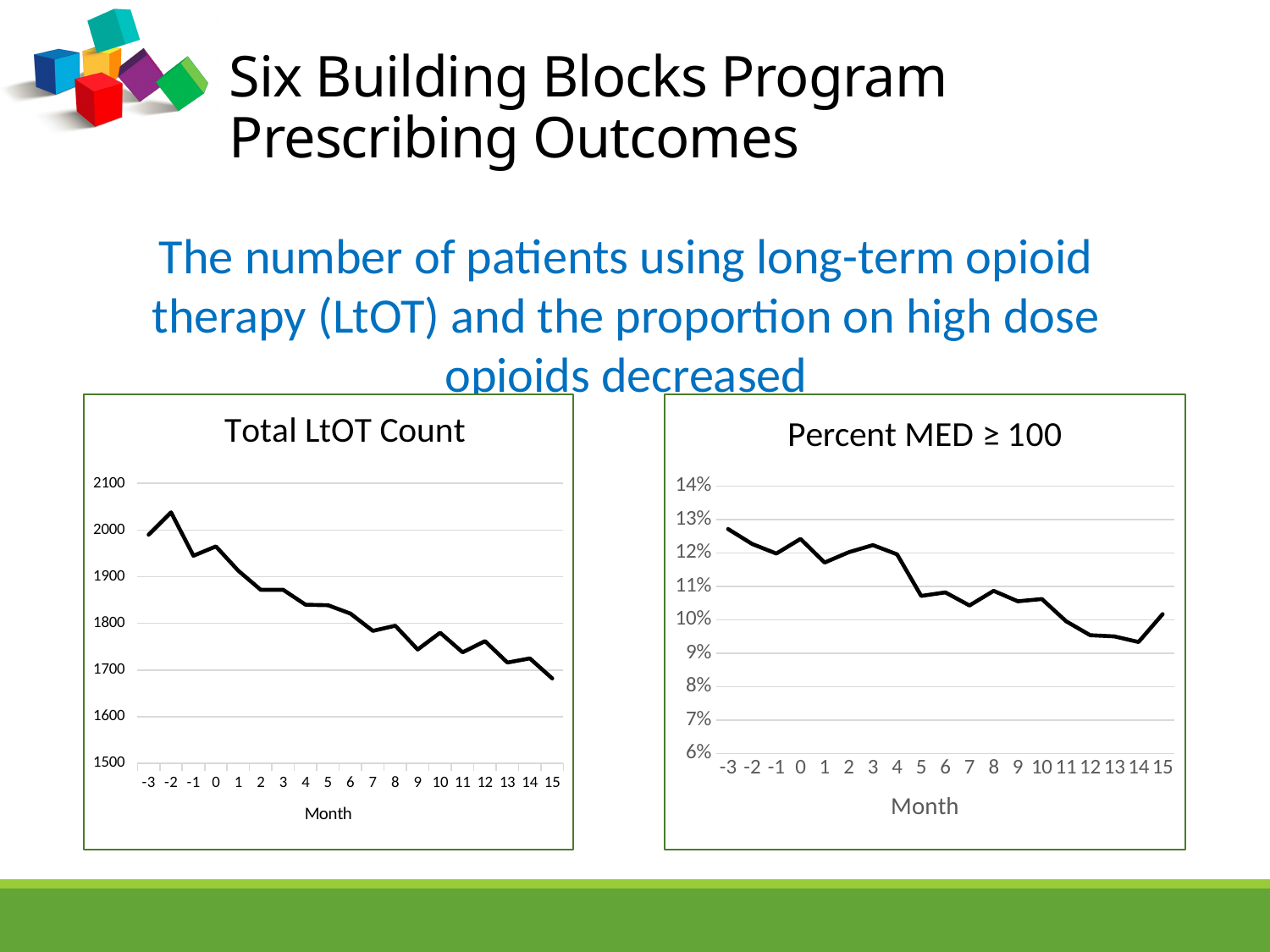
In the "Total LtOT Count" chart, at which month is the count highest? -2 In the "Total LtOT Count" chart, is the value for month -2 greater or less than 2000? greater In the "Percent MED ≥ 100" chart, at which month is the percentage highest? -3 Overall, do the values in the "Total LtOT Count" chart rise or fall from month -3 to month 15? fall In the "Total LtOT Count" chart, is the value for month 7 greater or less than 1800? less In the "Percent MED ≥ 100" chart, is the value for month 12 greater or less than 10%? less In the "Total LtOT Count" chart, how many months are plotted along the x axis? 19 In the "Percent MED ≥ 100" chart, how many months are plotted along the x axis? 19 What type of chart is the "Percent MED ≥ 100" chart? line chart What type of chart is the "Total LtOT Count" chart? line chart In the "Total LtOT Count" chart, at which month is the count lowest? 15 In the "Percent MED ≥ 100" chart, at which month is the percentage lowest? 14